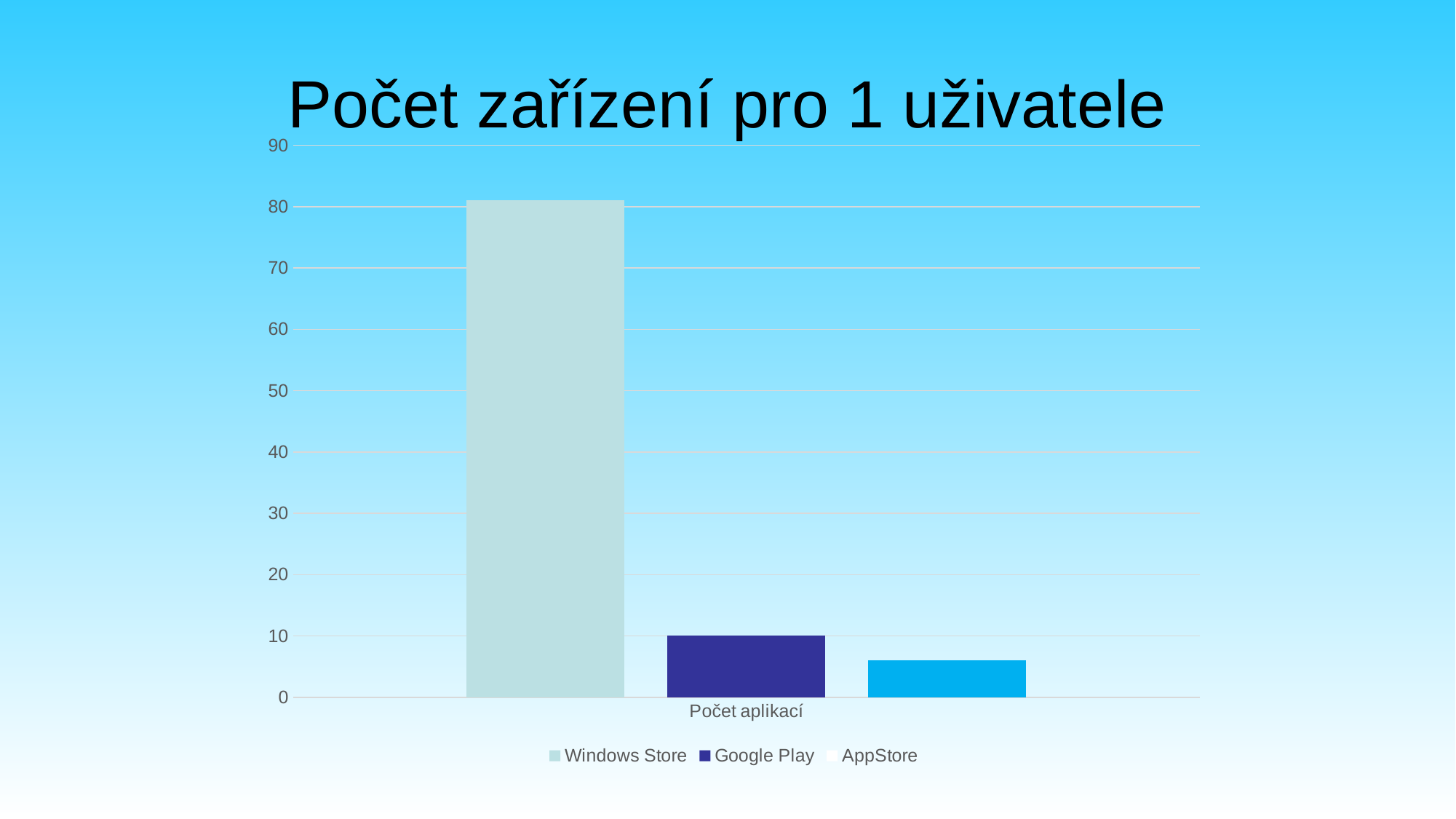
Is the value for Windows Store greater or less than 70? greater Which series has the lowest bar? AppStore Is the value for AppStore greater or less than 10? less What is the title of the chart? Počet zařízení pro 1 uživatele How many categories are shown on the x axis? 1 Which is larger, the value for Windows Store or the value for Google Play? Windows Store What kind of chart is shown on the slide? bar chart Which series are listed in the legend? Windows Store, Google Play, AppStore What is the value for Google Play? 10 Which is larger, the value for Google Play or the value for AppStore? Google Play Which series has the highest bar? Windows Store How many series does the legend list? 3